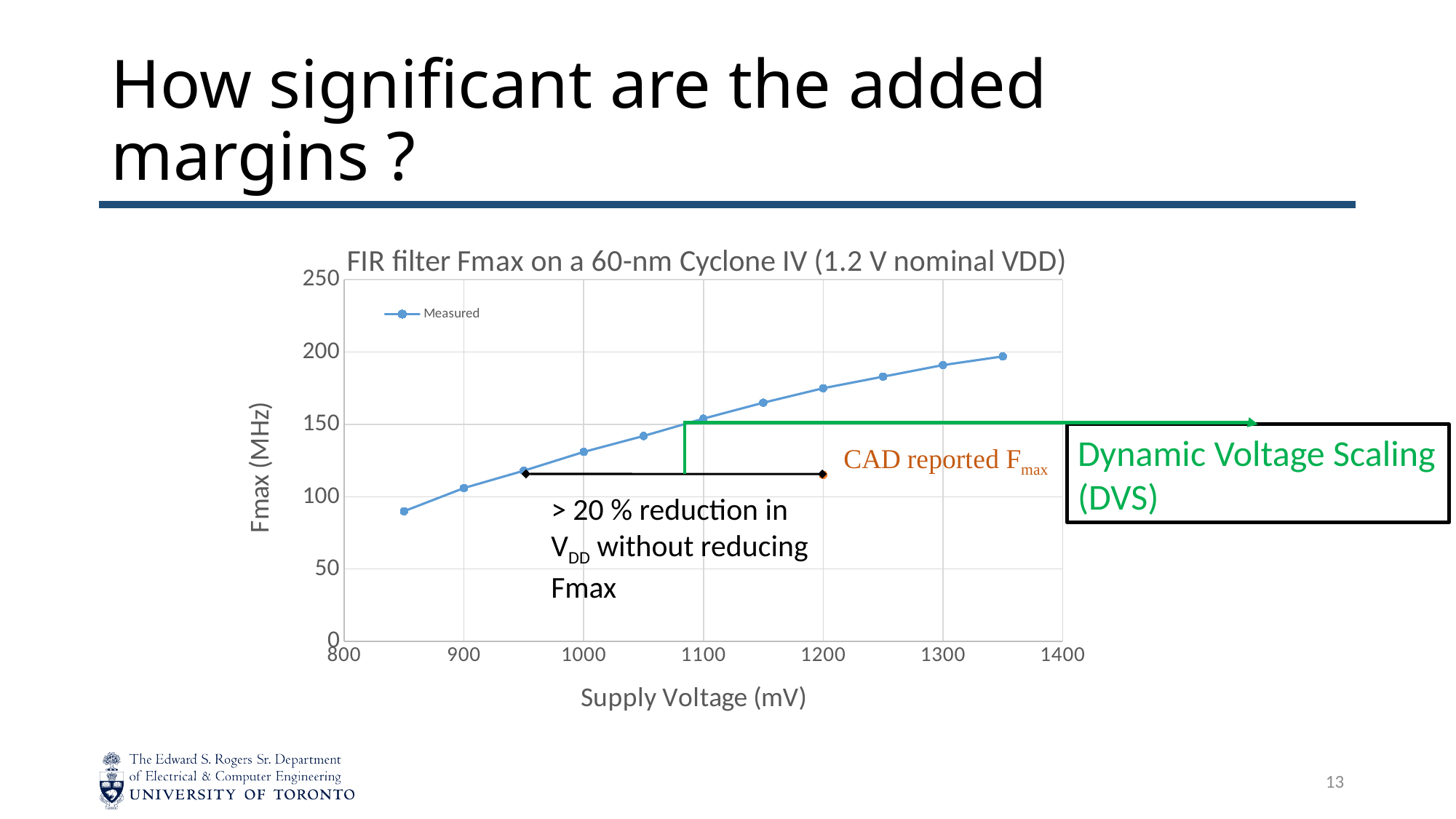
At which supply voltage is the measured Fmax highest? 1350 mV Which supply voltage has the larger measured Fmax, 1000 mV or 1200 mV? 1200 mV Is the measured Fmax at 850 mV greater or less than 100 MHz? less Is the measured Fmax at 1350 mV greater or less than 150 MHz? greater What is the title of the chart? FIR filter Fmax on a 60-nm Cyclone IV (1.2 V nominal VDD) How many data points are plotted on the Measured line? 11 At which supply voltage is the measured Fmax lowest? 850 mV Does Fmax rise or fall as supply voltage increases along the x axis? rise Is the measured Fmax at 1300 mV greater or less than 200 MHz? less How many series does the chart legend list? 1 What is the name of the series in the chart legend? Measured What kind of chart is shown on the slide? line chart